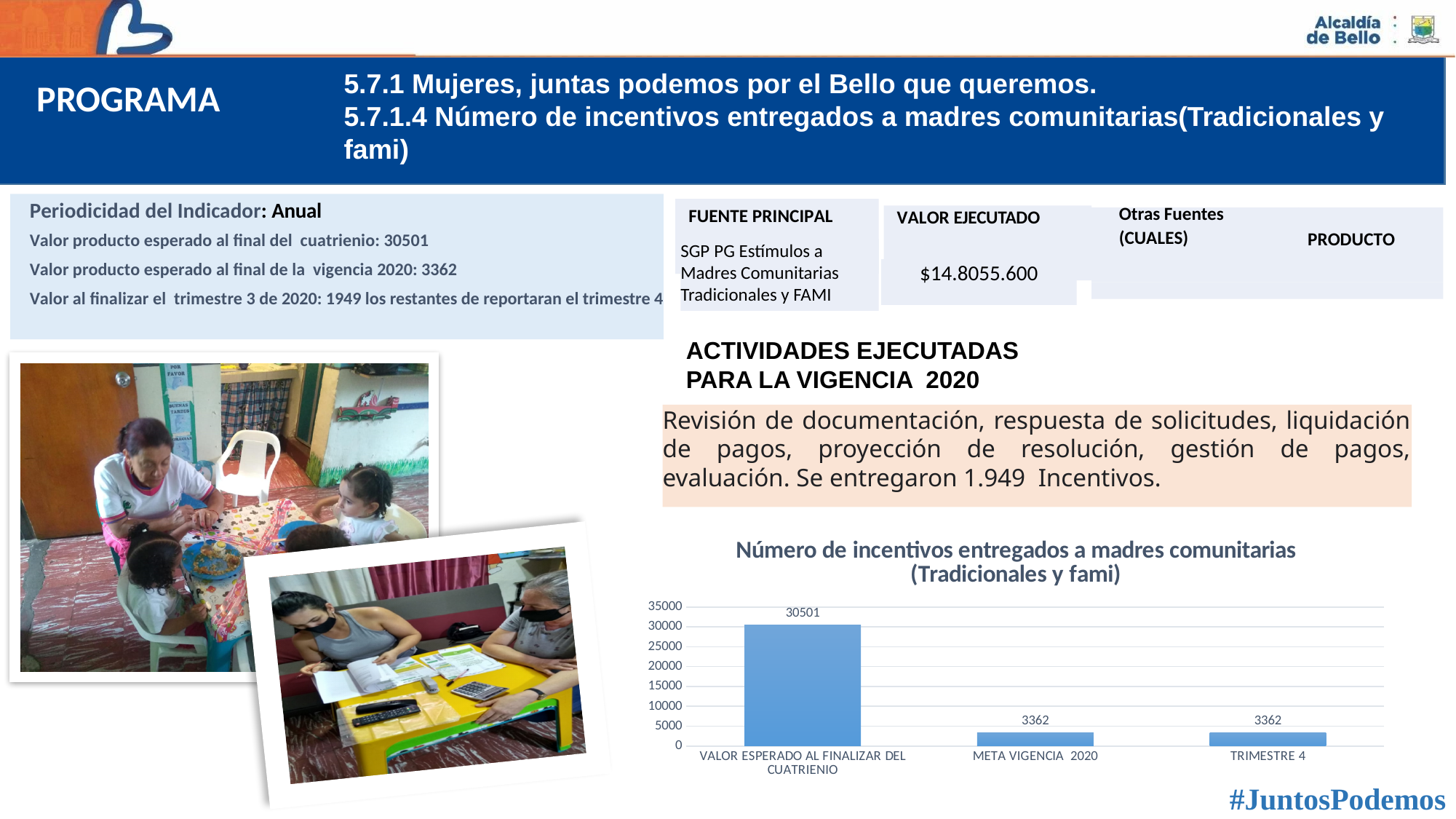
Which is larger, VALOR ESPERADO AL FINALIZAR DEL CUATRIENIO or TRIMESTRE 4? VALOR ESPERADO AL FINALIZAR DEL CUATRIENIO What is the difference between VALOR ESPERADO AL FINALIZAR DEL CUATRIENIO and META VIGENCIA 2020? 27139 What is the value for META VIGENCIA 2020? 3362 What kind of chart is shown? bar chart Is the value for META VIGENCIA 2020 greater or less than 5000? less Which category has the highest value? VALOR ESPERADO AL FINALIZAR DEL CUATRIENIO What is the title of the chart? Número de incentivos entregados a madres comunitarias (Tradicionales y fami) How many categories are shown on the chart? 3 What is the value for TRIMESTRE 4? 3362 What is the highest value shown on the vertical axis? 35000 What is the value for VALOR ESPERADO AL FINALIZAR DEL CUATRIENIO? 30501 Is the value for VALOR ESPERADO AL FINALIZAR DEL CUATRIENIO greater or less than 25000? greater